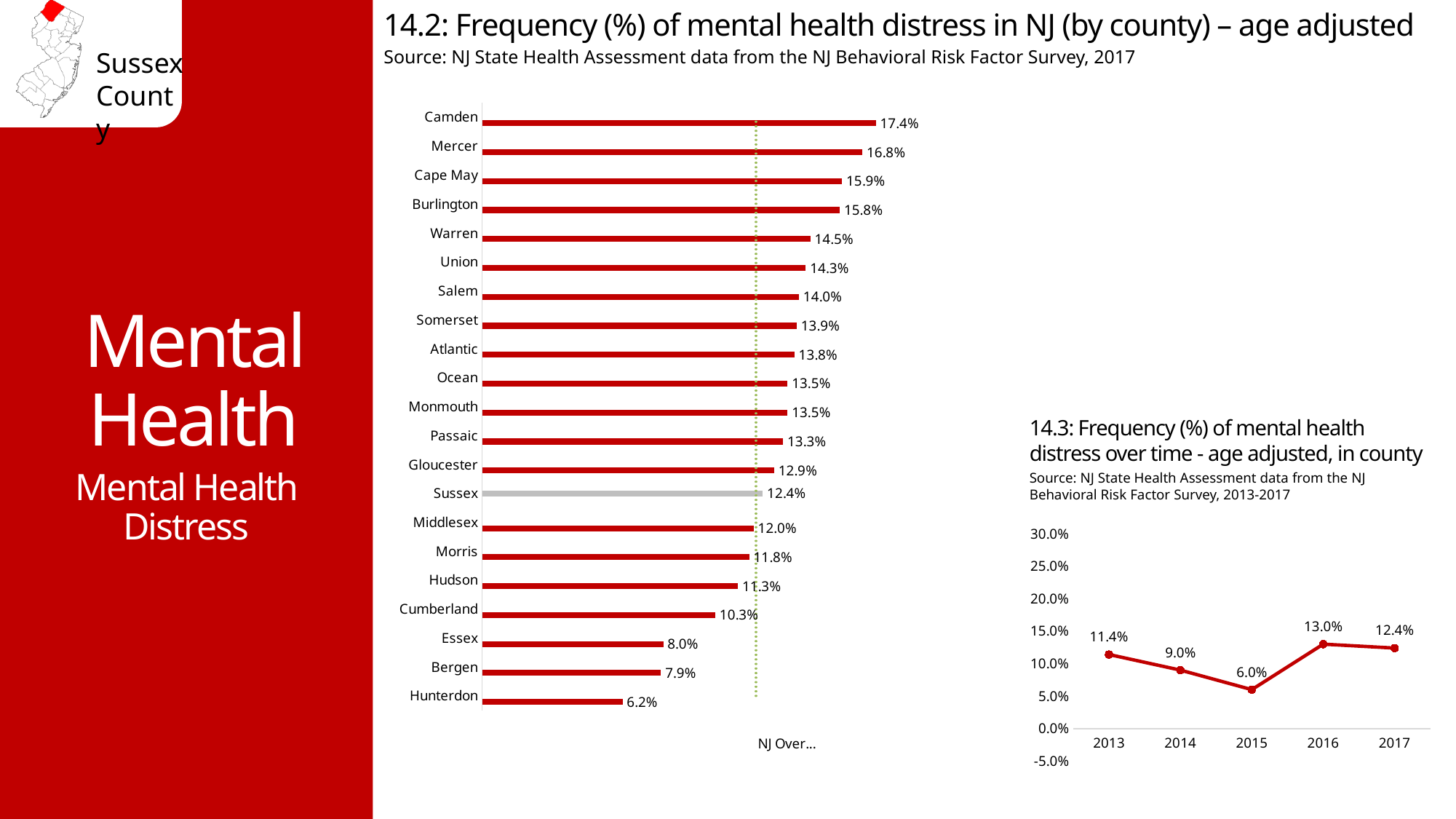
In chart 14.2 (frequency of mental health distress by county), how many counties are plotted? 21 What kind of chart is chart 14.3 (frequency of mental health distress over time)? Line chart In chart 14.2 (frequency of mental health distress by county), which county has the highest value? Camden In chart 14.3 (frequency of mental health distress over time), which year has the highest value? 2016 In chart 14.3 (frequency of mental health distress over time), what is the value for 2015? 6.0% In chart 14.2 (frequency of mental health distress by county), which county has the lowest value? Hunterdon In chart 14.3 (frequency of mental health distress over time), what is the difference between 2016 and 2015? 7.0% In chart 14.2 (frequency of mental health distress by county), what is the difference between Camden and Hunterdon? 11.2% In chart 14.2 (frequency of mental health distress by county), which is larger, the value for Warren or the value for Union? Warren What kind of chart is chart 14.2 (frequency of mental health distress by county)? Bar chart In chart 14.2 (frequency of mental health distress by county), what is the value for Cumberland? 10.3% In chart 14.2 (frequency of mental health distress by county), what is the value for Sussex? 12.4%